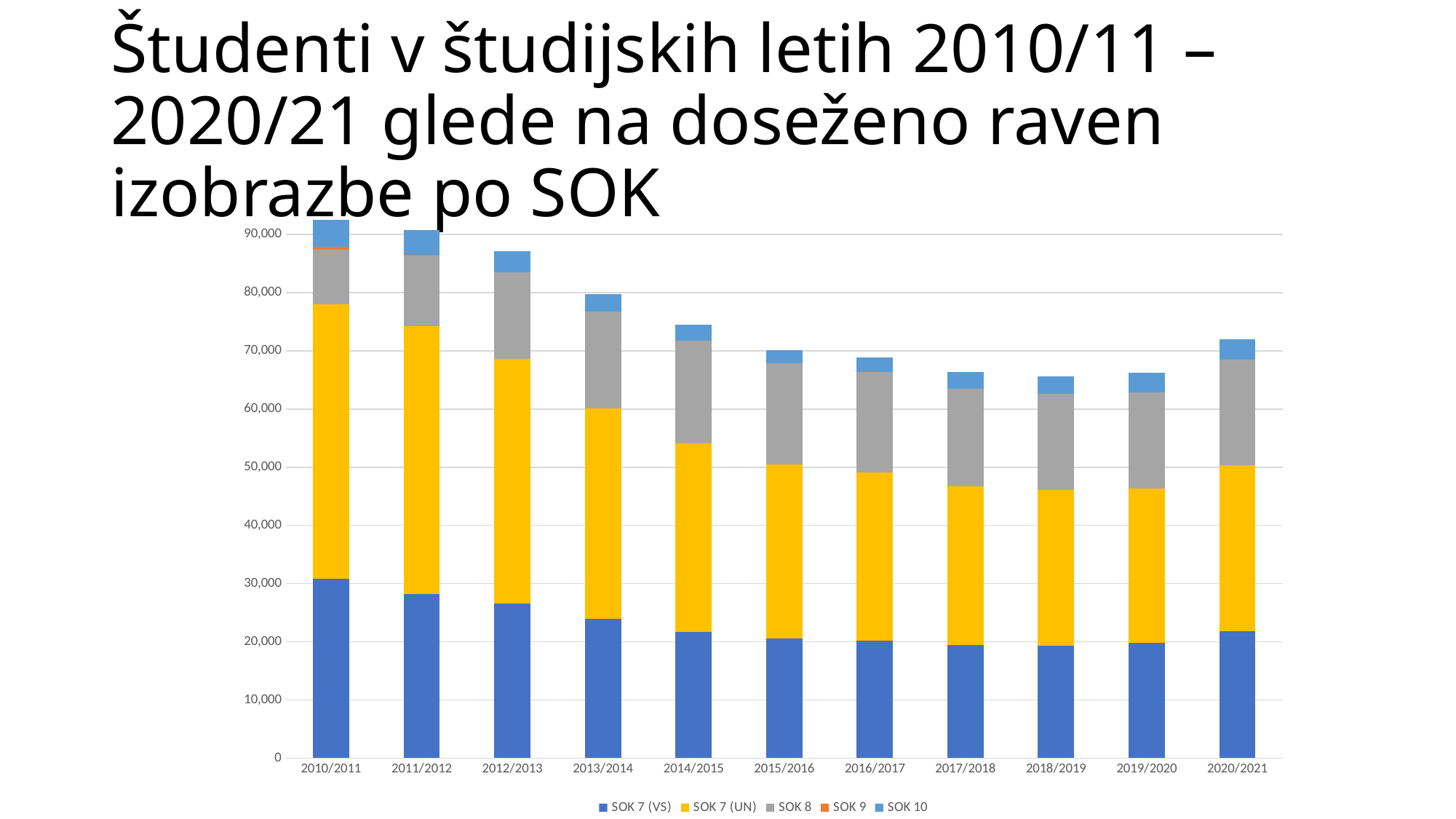
Which has the larger total bar, 2010/2011 or 2020/2021? 2010/2011 Is the total bar for 2020/2021 greater or less than 70,000? greater Is the total bar for 2014/2015 greater or less than 80,000? less Do the total bar heights generally rise or fall from 2010/2011 to 2018/2019? fall What kind of chart is shown on the slide? Stacked bar chart Is the total bar for 2012/2013 greater or less than 90,000? less Which study year has the highest total bar? 2010/2011 Which has the larger SOK 7 (VS) value, 2010/2011 or 2020/2021? 2010/2011 How many series does the legend list? 5 How many study years (categories) are shown on the x axis? 11 Which series is shown in yellow? SOK 7 (UN)